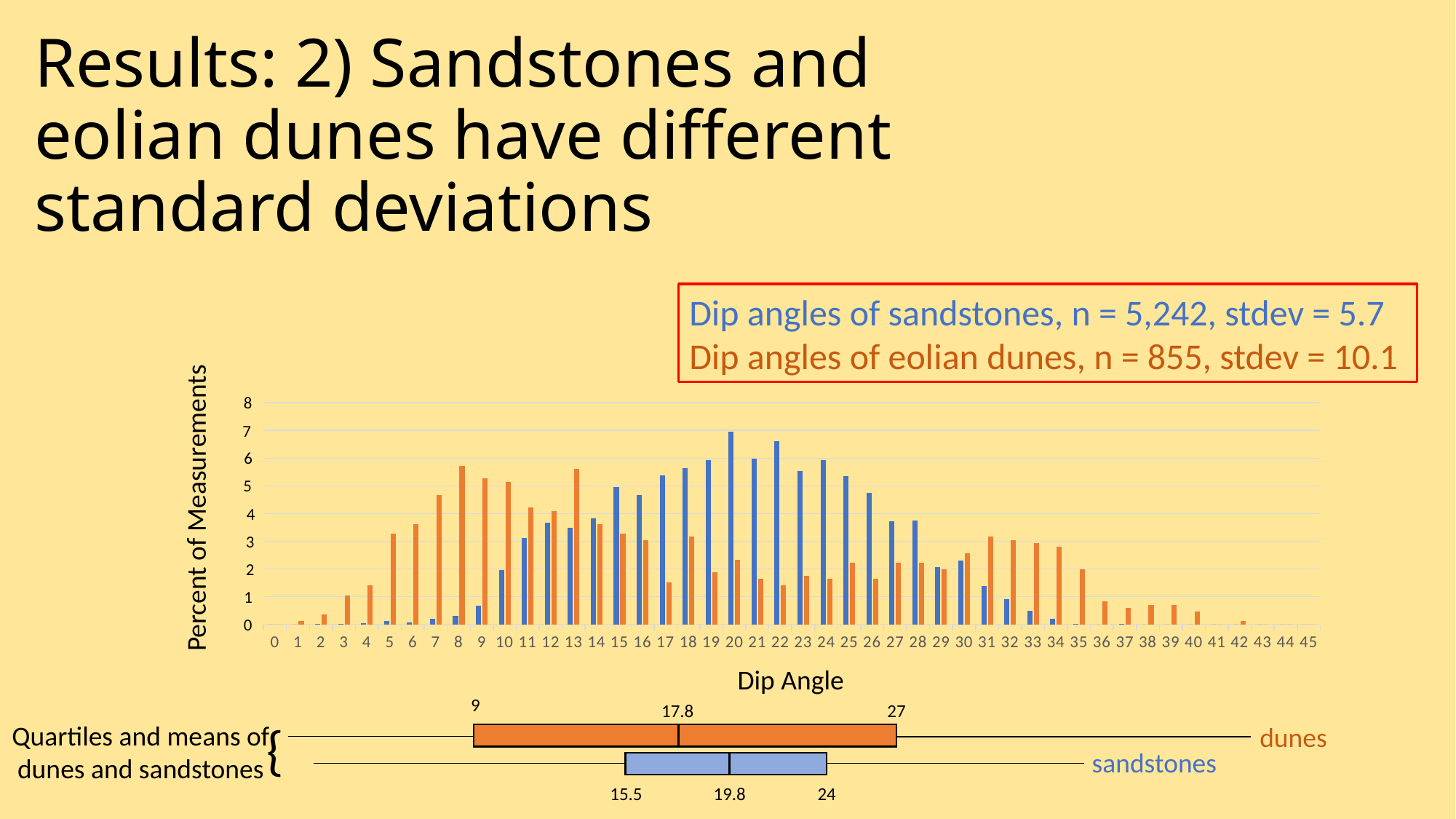
In the bar chart, which is larger at dip angle 7: the sandstones value or the eolian dunes value? eolian dunes In the bar chart, at which dip angle is the sandstones series highest? 20 How many dip angle categories are shown on the x axis of the bar chart? 46 What kind of chart is the main chart on the slide? bar chart In the box plot at the bottom, what is the mean dip angle for dunes? 17.8 In the bar chart, is the value for sandstones at dip angle 10 greater or less than 3? less In the box plot at the bottom, what is the difference between the upper and lower quartiles for dunes? 18 In the bar chart, is the value for sandstones at dip angle 20 greater or less than 6? greater In the bar chart, which is larger at dip angle 18: the sandstones value or the eolian dunes value? sandstones In the bar chart, is the value for eolian dunes at dip angle 8 greater or less than 5? greater In the box plot at the bottom, what is the mean dip angle for sandstones? 19.8 What is the y-axis title of the bar chart? Percent of Measurements